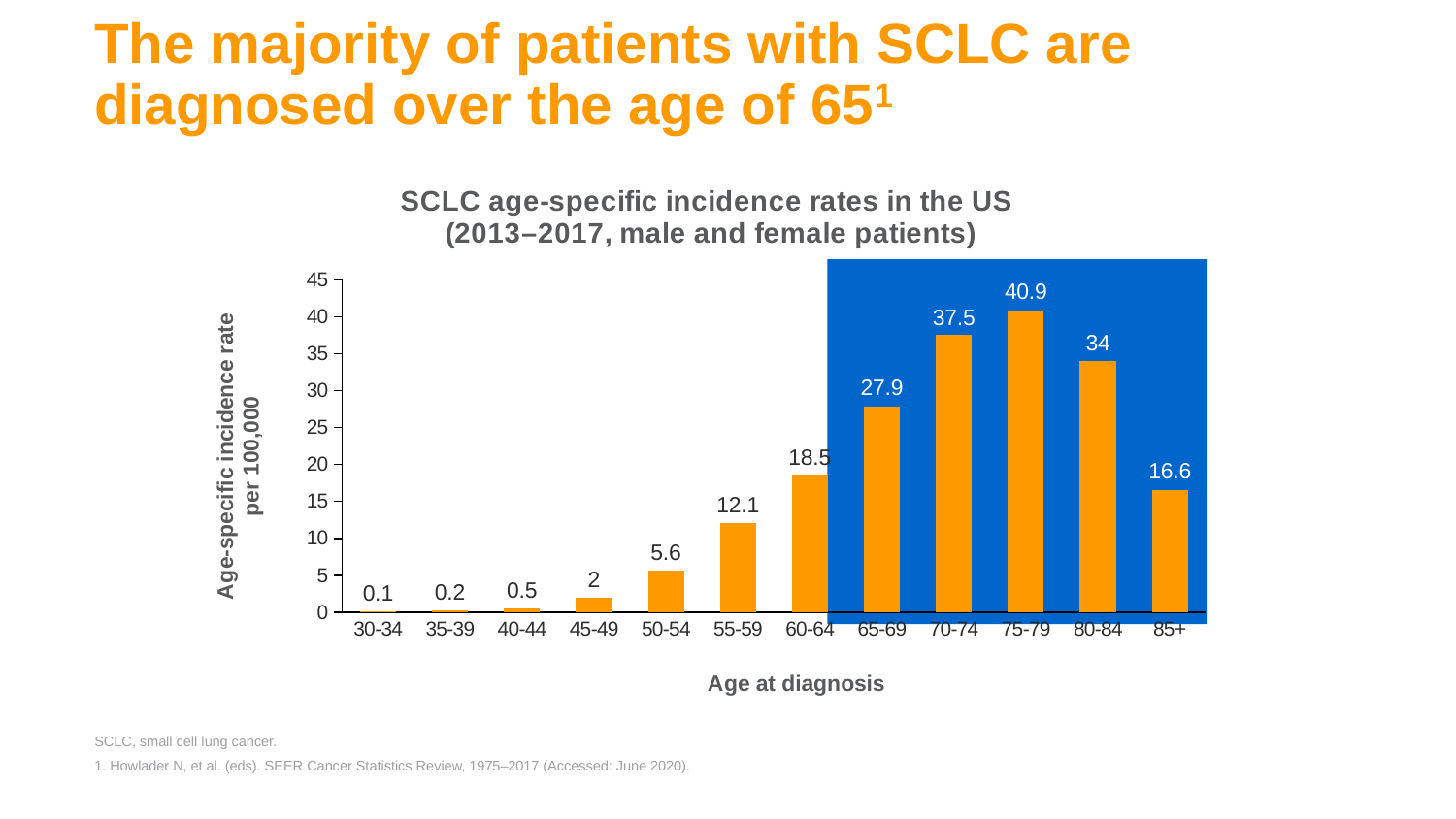
What is the age-specific incidence rate for the 85+ age group? 16.6 Which age group has the highest incidence rate? 75-79 What is the difference between the incidence rates for the 75-79 and 80-84 age groups? 6.9 What kind of chart is shown on the slide? Bar chart Which age group has a higher incidence rate, 65-69 or 85+? 65-69 Is the value for the 70-74 age group greater or less than 35? greater What is the age-specific incidence rate for the 75-79 age group? 40.9 What is the age-specific incidence rate for the 55-59 age group? 12.1 What is the title of the chart? SCLC age-specific incidence rates in the US (2013–2017, male and female patients) How many age groups are shown on the x axis? 12 Which age group has the lowest incidence rate? 30-34 Do the incidence rates rise or fall from the 30-34 age group to the 75-79 age group? Rise